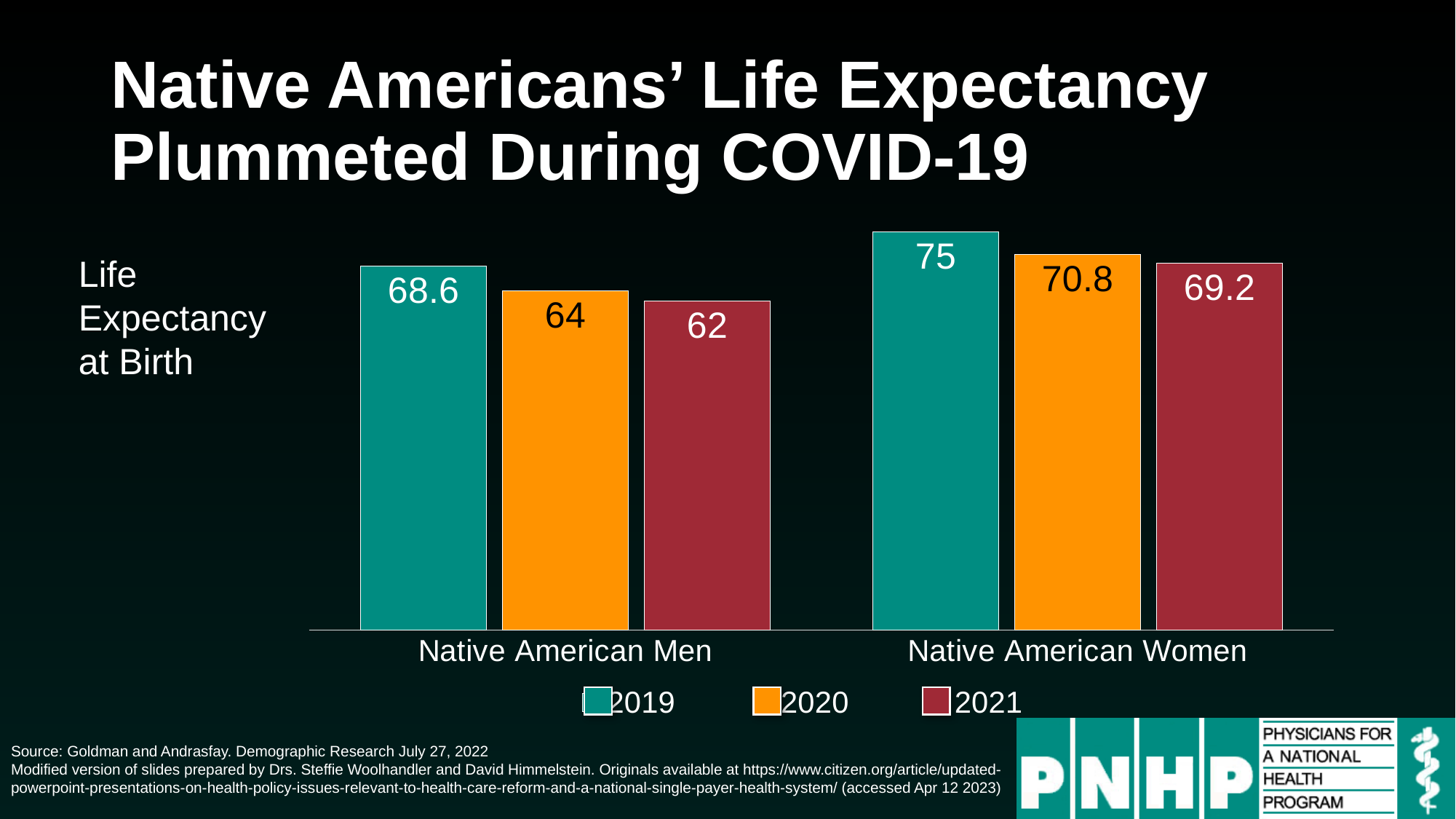
Which year shows the lowest life expectancy for Native American Men? 2021 What is the difference between the 2019 life expectancy of Native American Women and Native American Men? 6.4 By how much did life expectancy for Native American Men fall from 2019 to 2021? 6.6 Which year shows the highest life expectancy for Native American Women? 2019 Which is larger: the 2021 life expectancy for Native American Women or the 2019 life expectancy for Native American Men? Native American Women in 2021 What was the life expectancy at birth for Native American Men in 2020? 64 What was the life expectancy at birth for Native American Women in 2020? 70.8 What was the life expectancy at birth for Native American Men in 2019? 68.6 What was the life expectancy at birth for Native American Women in 2021? 69.2 Which colour represents the year 2020 in the chart? Orange How many series does the legend list? 3 What kind of chart is shown on the slide? Bar chart